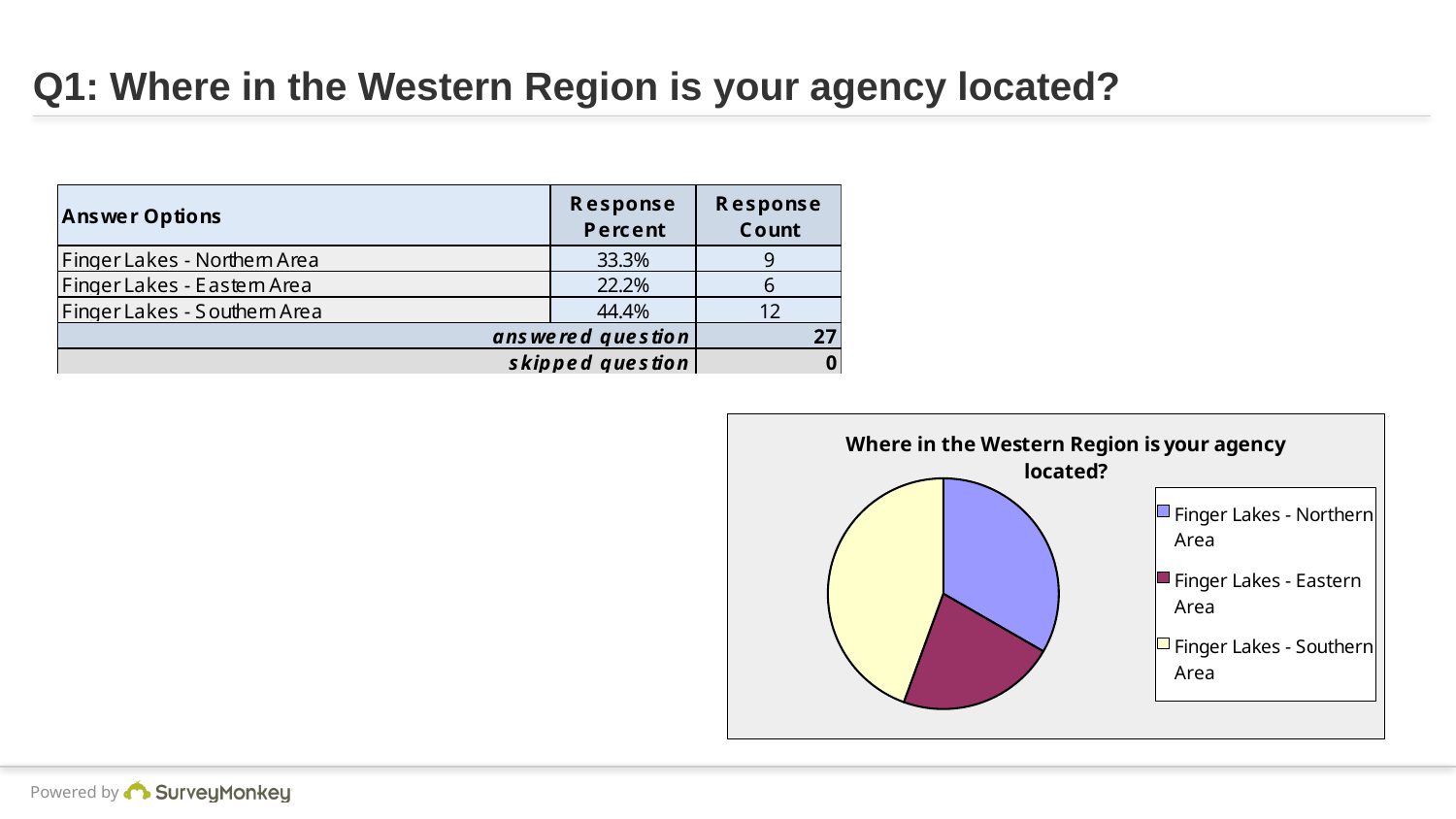
What share of the pie does Finger Lakes - Southern Area represent? 44.4% How many entries does the pie chart's legend list? 3 Which slice is larger, Finger Lakes - Northern Area or Finger Lakes - Eastern Area? Finger Lakes - Northern Area What is the response percent for Finger Lakes - Northern Area? 33.3% What is the title of the pie chart? Where in the Western Region is your agency located? How many slices does the pie chart have? 3 Which area has the smallest slice of the pie chart? Finger Lakes - Eastern Area What kind of chart is shown on the slide? pie chart What is the response count for Finger Lakes - Eastern Area? 6 Which area has the largest slice of the pie chart? Finger Lakes - Southern Area What is the response count for Finger Lakes - Southern Area? 12 What is the difference in response count between Finger Lakes - Southern Area and Finger Lakes - Eastern Area? 6